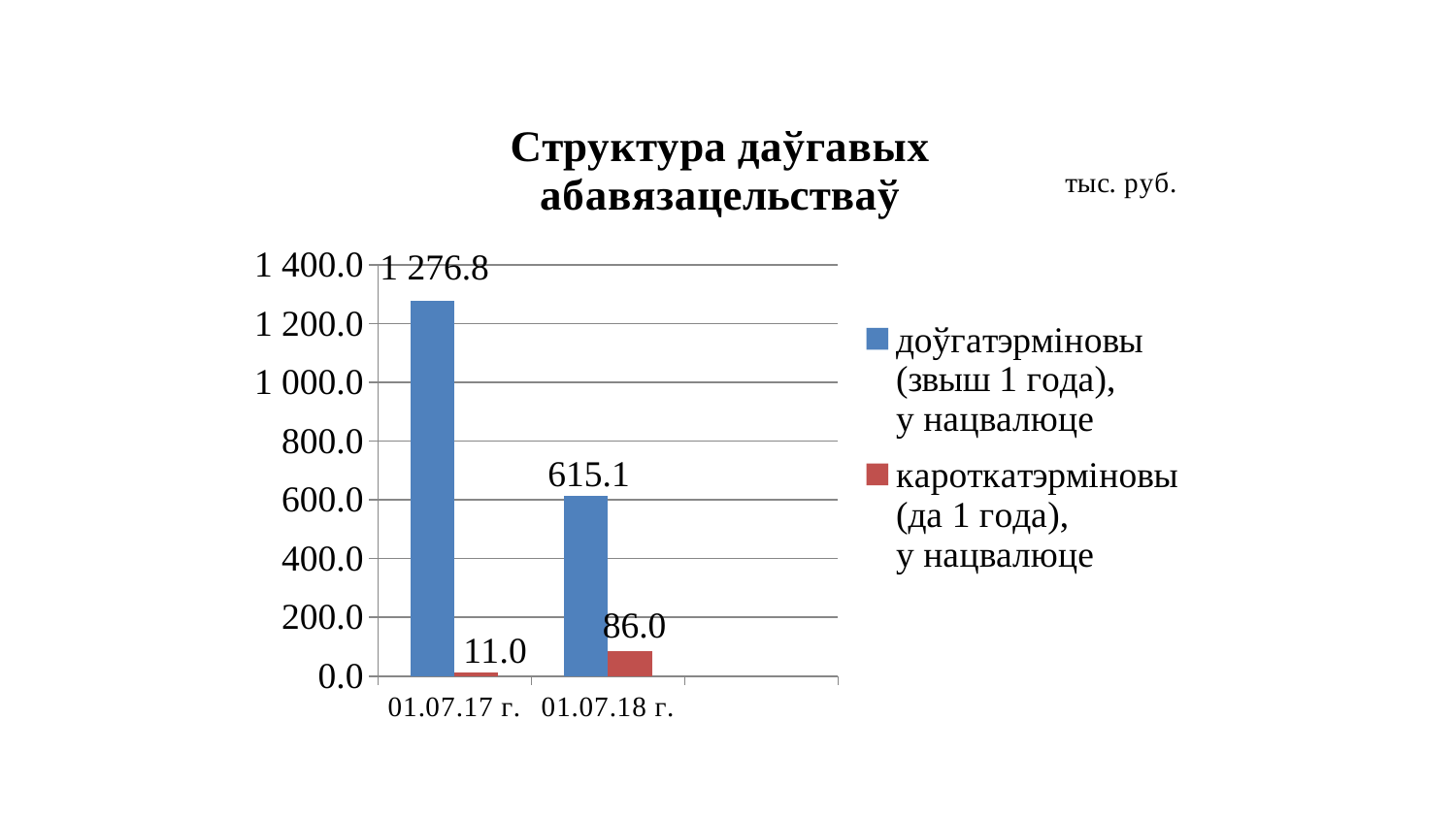
What is the value of the short-term (кароткатэрміновы) series for 01.07.18 г.? 86.0 What is the value of the short-term (кароткатэрміновы) series for 01.07.17 г.? 11.0 How many series does the legend list? 2 Which date has the lower short-term (кароткатэрміновы) value? 01.07.17 г. What unit is indicated for the values on the chart? тыс. руб. What is the value of the long-term (доўгатэрміновы) series for 01.07.17 г.? 1 276.8 What is the value of the long-term (доўгатэрміновы) series for 01.07.18 г.? 615.1 Is the long-term value for 01.07.18 г. greater or less than 800.0? less By how much did the long-term (доўгатэрміновы) value decrease from 01.07.17 г. to 01.07.18 г.? 661.7 What type of chart is shown on the slide? Bar chart What is the difference between the short-term values for 01.07.18 г. and 01.07.17 г.? 75.0 Which date has the higher long-term (доўгатэрміновы) value? 01.07.17 г.